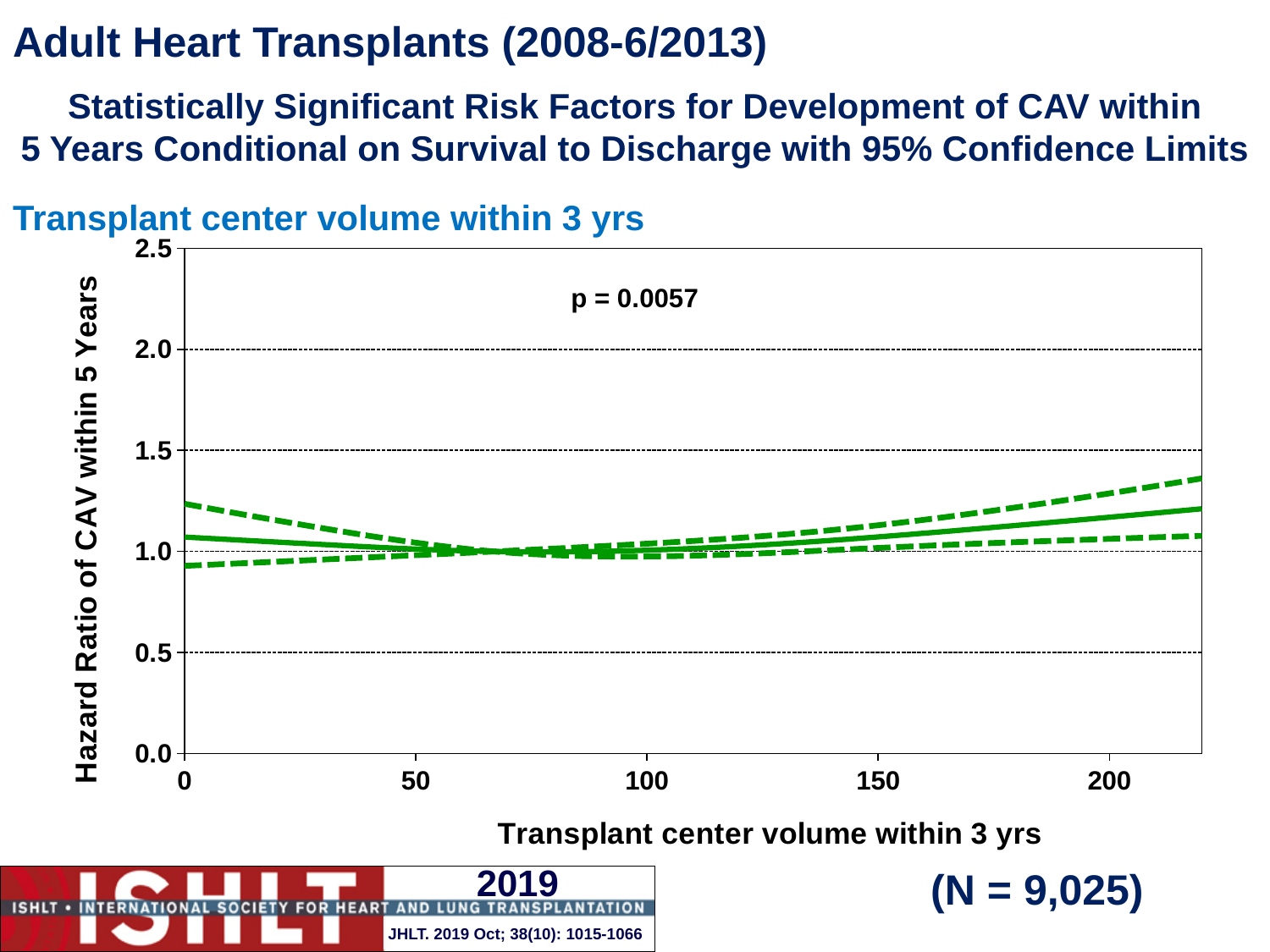
What kind of chart is shown on the slide? Line chart What is the highest tick value shown on the x-axis of the chart? 200 Is the hazard ratio (solid line) at a transplant center volume of 200 greater or less than 1.5? less Is the lower confidence limit (lower dashed line) at a transplant center volume of 0 greater or less than 1.0? less Between transplant center volumes of 100 and 200, does the hazard ratio (solid line) rise or fall? rise What p-value is printed on the chart? p = 0.0057 Is the hazard ratio (solid line) at a transplant center volume of 100 greater or less than 1.5? less What is the highest value shown on the y-axis of the chart? 2.5 What sample size (N) is shown on the slide? N = 9,025 Is the hazard ratio (solid line) at a transplant center volume of 200 higher or lower than at a volume of 100? higher How many lines (solid and dashed) are plotted on the chart? 3